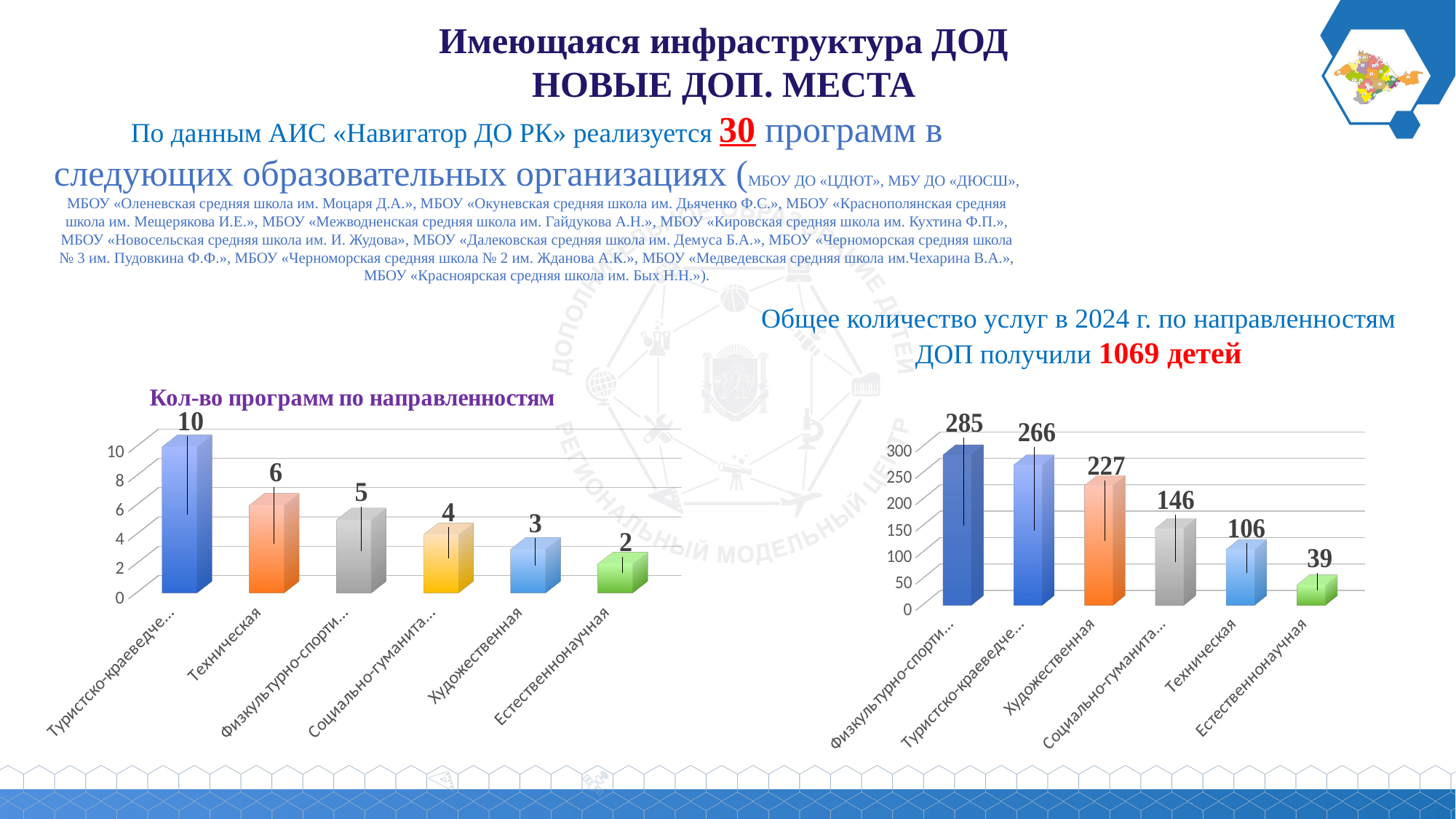
On the right chart, what is the value for Художественная? 227 On the right chart, what is the value for Естественнонаучная? 39 What type of chart is the right chart? Bar chart On the left chart (Кол-во программ по направленностям), what is the difference between Техническая and Естественнонаучная? 4 On the right chart, which is larger: Художественная or Техническая? Художественная On the left chart (Кол-во программ по направленностям), what is the value for Художественная? 3 On the right chart, what is the value for Техническая? 106 On the left chart (Кол-во программ по направленностям), which category has the lowest value? Естественнонаучная On the left chart (Кол-во программ по направленностям), what is the value for Техническая? 6 On the right chart, what is the difference between Художественная and Техническая? 121 On the left chart (Кол-во программ по направленностям), how many categories are shown? 6 On the left chart (Кол-во программ по направленностям), what is the highest value shown? 10